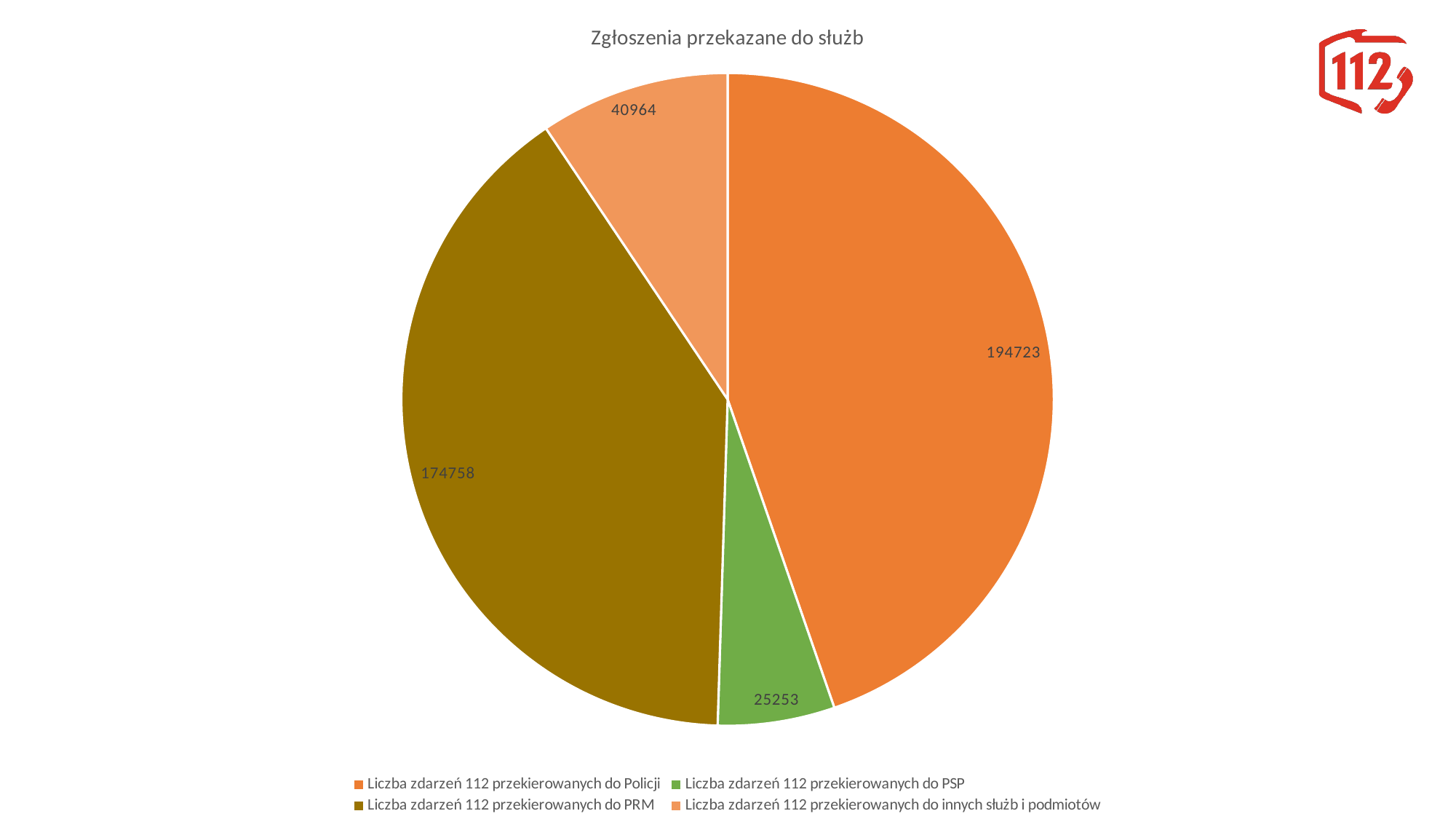
Which category has the smallest slice? Liczba zdarzeń 112 przekierowanych do PSP What is the value for 'Liczba zdarzeń 112 przekierowanych do PRM'? 174758 What is the title of the chart? Zgłoszenia przekazane do służb What type of chart is shown on the slide? pie chart Which category has the largest slice? Liczba zdarzeń 112 przekierowanych do Policji What is the total of all four slices? 435698 What is the value for 'Liczba zdarzeń 112 przekierowanych do Policji'? 194723 What is the value for 'Liczba zdarzeń 112 przekierowanych do PSP'? 25253 What is the value for 'Liczba zdarzeń 112 przekierowanych do innych służb i podmiotów'? 40964 Which is larger: the value for PSP or the value for innych służb i podmiotów? Liczba zdarzeń 112 przekierowanych do innych służb i podmiotów How many slices does the pie chart have? 4 What is the difference between the value for Policji and the value for PRM? 19965